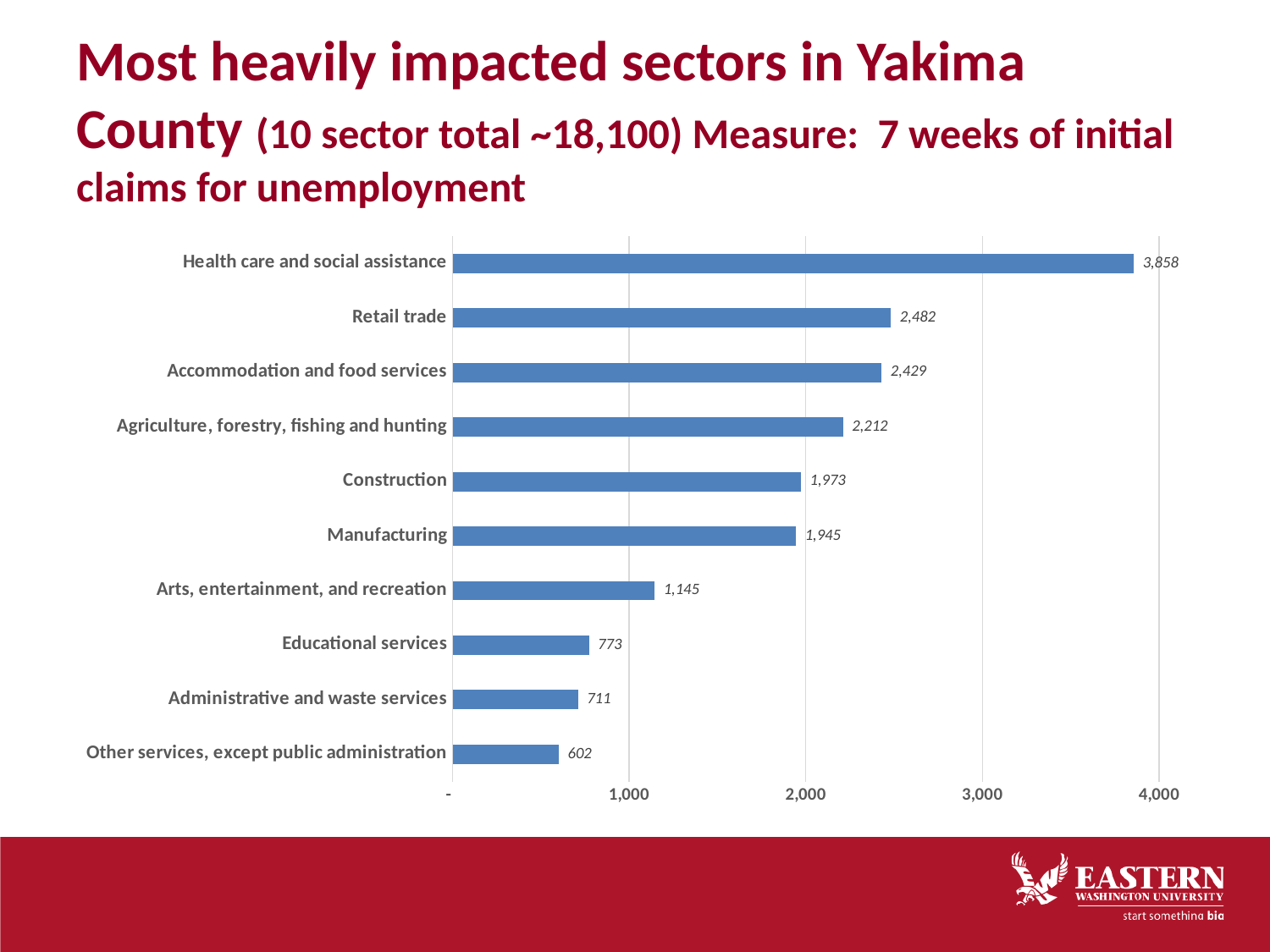
How many sectors are shown in the chart? 10 What is the value for Manufacturing? 1,945 What is the difference between Retail trade and Accommodation and food services? 53 What is the value for Construction? 1,973 Which sector has the lowest value? Other services, except public administration What kind of chart is shown on the slide? bar chart What is the value for Other services, except public administration? 602 What is the value for Health care and social assistance? 3,858 Which sector has the highest value? Health care and social assistance What is the difference between Health care and social assistance and Retail trade? 1,376 Which is larger, Educational services or Administrative and waste services? Educational services Is the value for Arts, entertainment, and recreation greater or less than 1,000? greater